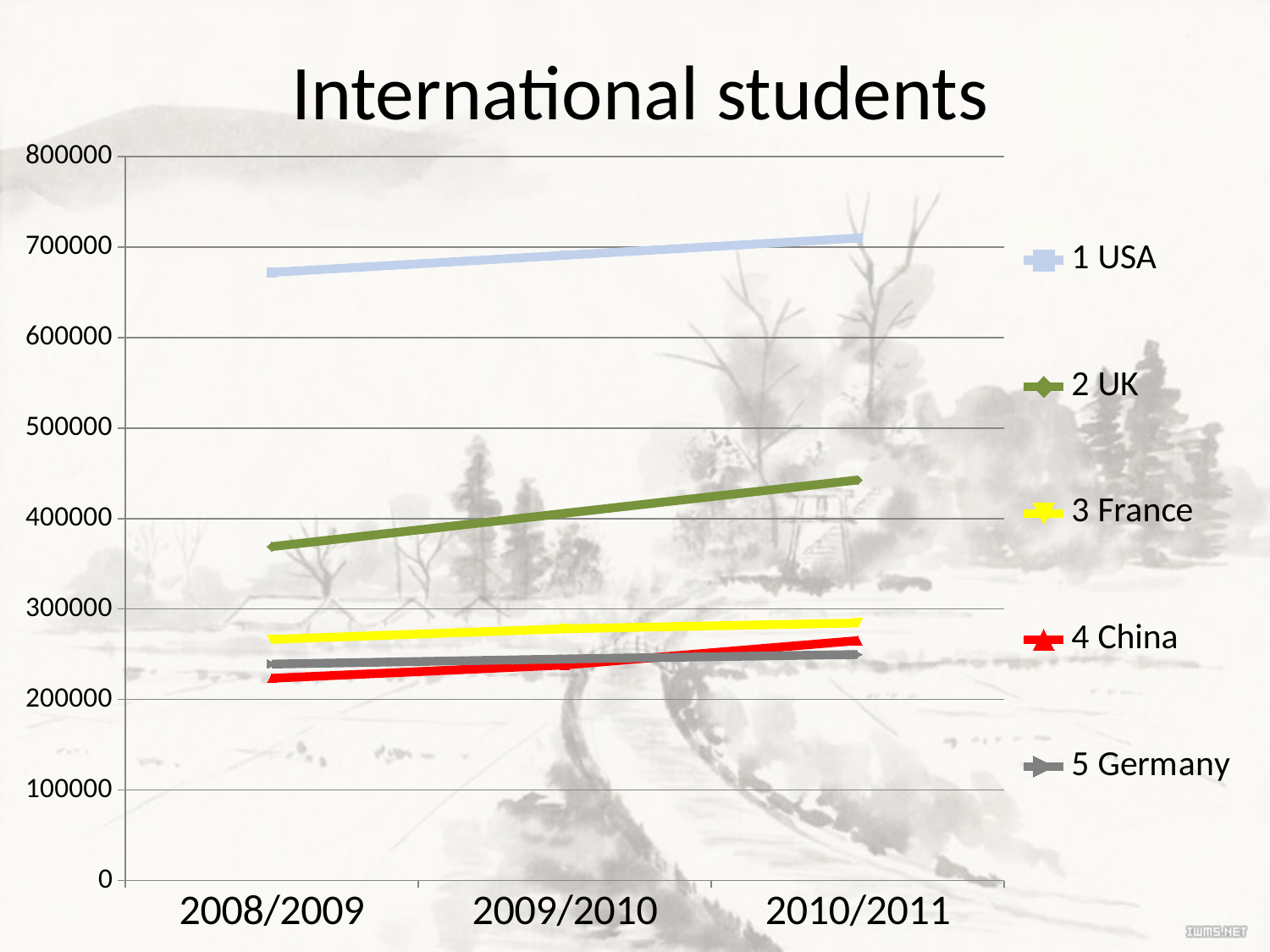
Is the value for 3 France in 2010/2011 greater or less than 300000? less Which country has the highest number of international students in 2010/2011? 1 USA Is the value for 2 UK in 2010/2011 greater or less than 400000? greater Is the value for 1 USA in 2008/2009 greater or less than 700000? less In 2010/2011, which is larger: the value for 2 UK or the value for 3 France? 2 UK Which country has the lowest number of international students in 2008/2009? 4 China Does the number of international students for 2 UK rise or fall from 2008/2009 to 2010/2011? rise How many academic years are shown on the x axis? 3 How many series does the legend list? 5 What kind of chart is shown on the slide? line chart What is the title of the chart? International students